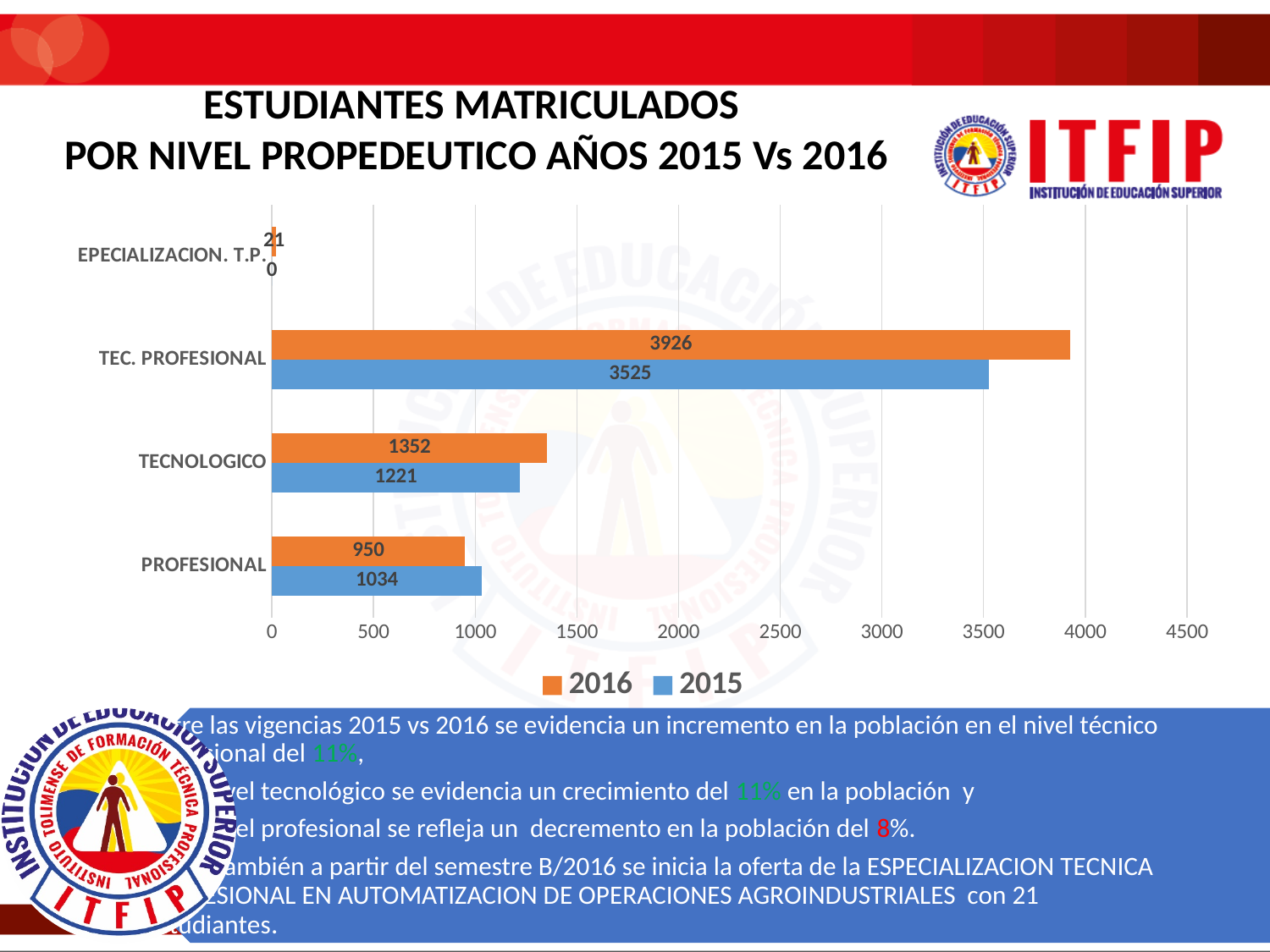
What is the 2015 value for TECNOLOGICO? 1221 For PROFESIONAL, which is larger: the 2016 value or the 2015 value? 2015 Which colour represents the 2016 series in the legend? orange How many series does the legend list? 2 Which category has the highest 2016 value? TEC. PROFESIONAL What is the difference between the 2016 and 2015 values for TEC. PROFESIONAL? 401 What type of chart is shown on the slide? bar chart How many categories are shown on the chart? 4 What is the 2016 value for EPECIALIZACION. T.P.? 21 What is the 2015 value for PROFESIONAL? 1034 Which category has the lowest 2015 value? EPECIALIZACION. T.P. What is the 2016 value for TEC. PROFESIONAL? 3926